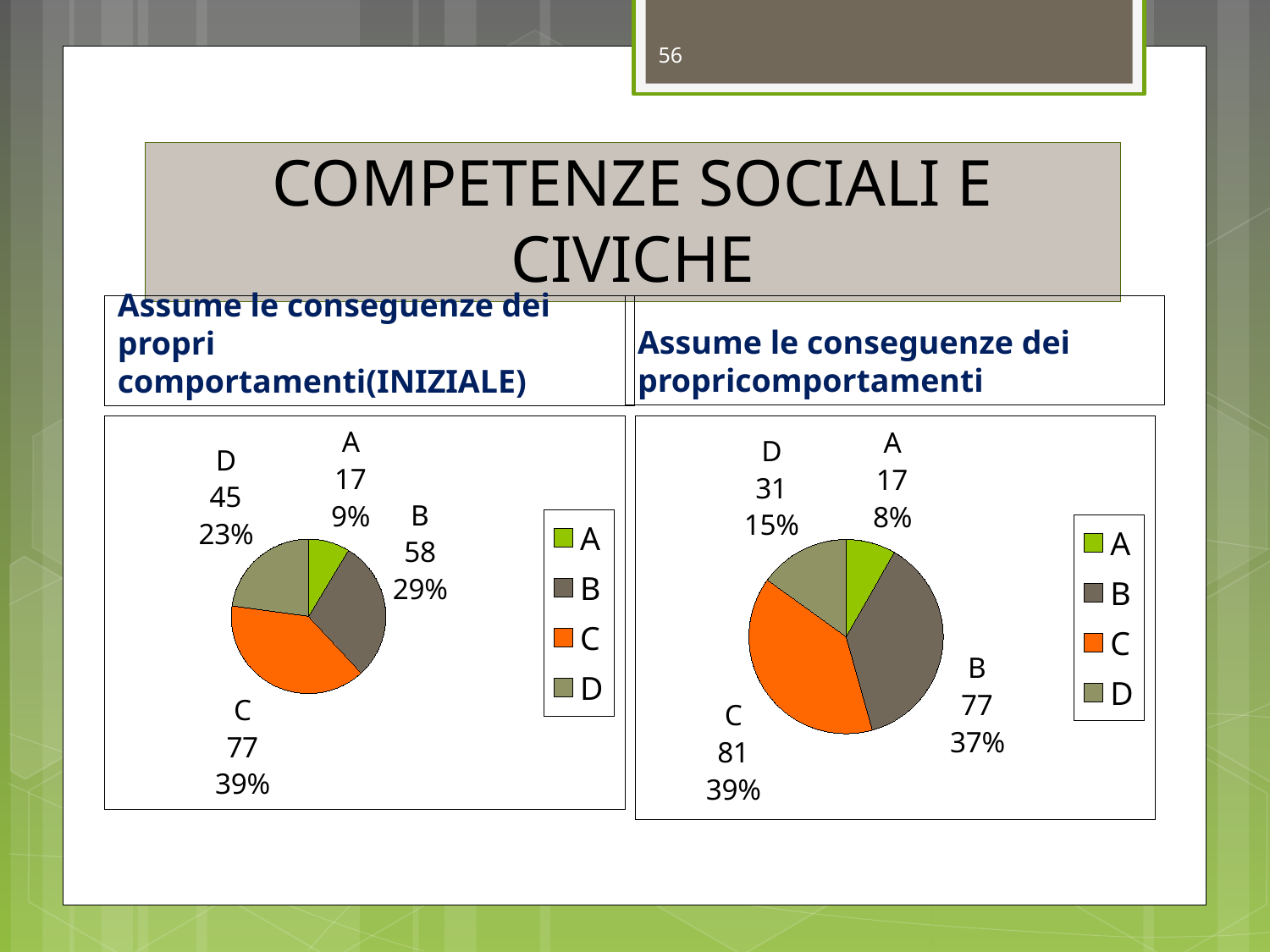
In the left pie chart (INIZIALE), what is the value for category C? 77 In the right pie chart, what is the difference between the values for D and A? 14 In the right pie chart, which colour represents category C? Orange What type of chart is used on the right side of the slide? Pie chart In the left pie chart (INIZIALE), what percentage share does category D have? 23% In the right pie chart, which category has the largest value? C In the right pie chart, what is the value for category B? 77 In the left pie chart (INIZIALE), which category has the smallest value? A In the right pie chart, which is larger, the value for B or the value for D? B In the left pie chart (INIZIALE), what is the difference between the values for C and B? 19 How many slices does the left pie chart (INIZIALE) have? 4 In the right pie chart, what percentage share does category A have? 8%